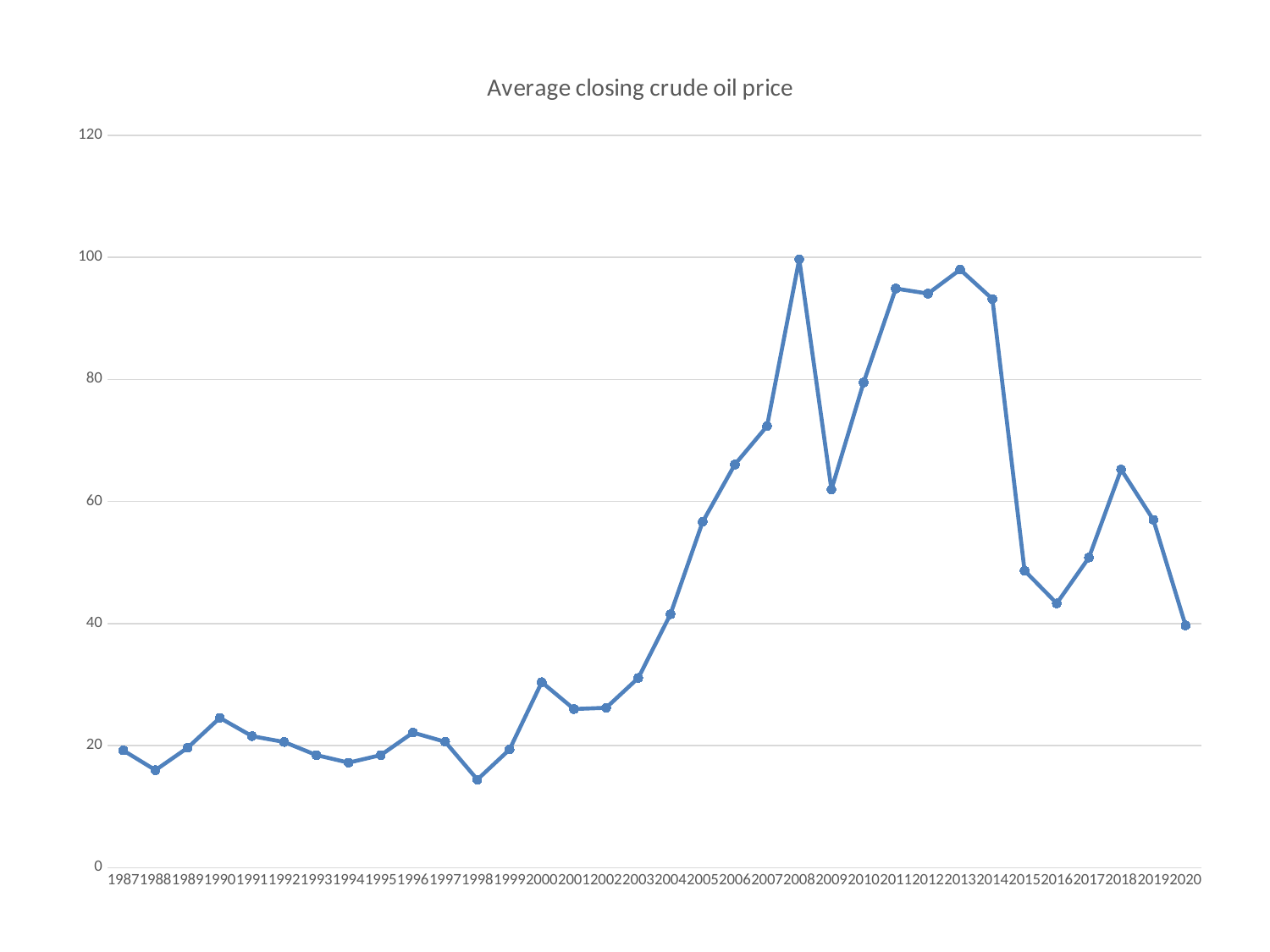
Which year has the higher value, 2011 or 2016? 2011 What kind of chart is shown on the slide? line chart Do the values rise or fall from 2013 to 2016? fall Which year has the higher value, 2008 or 2009? 2008 Do the values rise or fall from 2002 to 2008? rise Is the value for 2008 greater or less than 80? greater Is the value for 2000 greater or less than 20? greater What is the title of the chart? Average closing crude oil price Is the value for 2015 greater or less than 60? less How many years are plotted on the x axis? 34